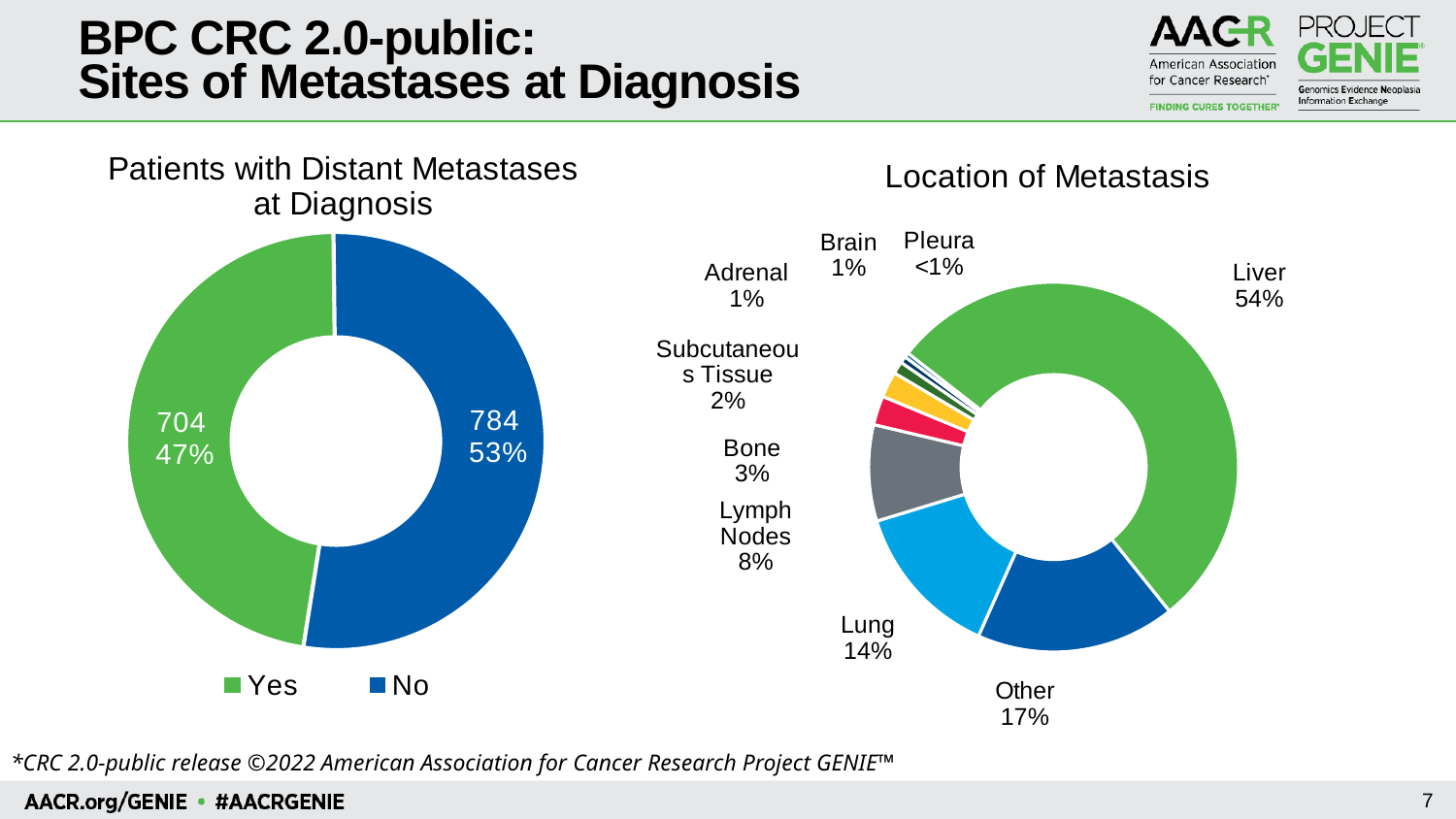
In the 'Location of Metastasis' chart, which location has the largest share? Liver In the 'Patients with Distant Metastases at Diagnosis' chart, how many entries does the legend list? 2 In the 'Patients with Distant Metastases at Diagnosis' chart, how many patients are in the 'No' category? 784 In the 'Patients with Distant Metastases at Diagnosis' chart, what is the difference in patient counts between 'No' and 'Yes'? 80 In the 'Location of Metastasis' chart, what percentage is shown for Liver? 54% What kind of chart is the 'Location of Metastasis' chart? Pie chart (donut) In the 'Location of Metastasis' chart, which location has the smallest share? Pleura In the 'Patients with Distant Metastases at Diagnosis' chart, what percentage of patients are in the 'Yes' category? 47% In the 'Patients with Distant Metastases at Diagnosis' chart, which category has more patients, 'Yes' or 'No'? No In the 'Location of Metastasis' chart, what percentage is shown for Lung? 14% In the 'Location of Metastasis' chart, what is the difference in percentage points between Other and Lymph Nodes? 9 In the 'Location of Metastasis' chart, how many locations are labelled? 9